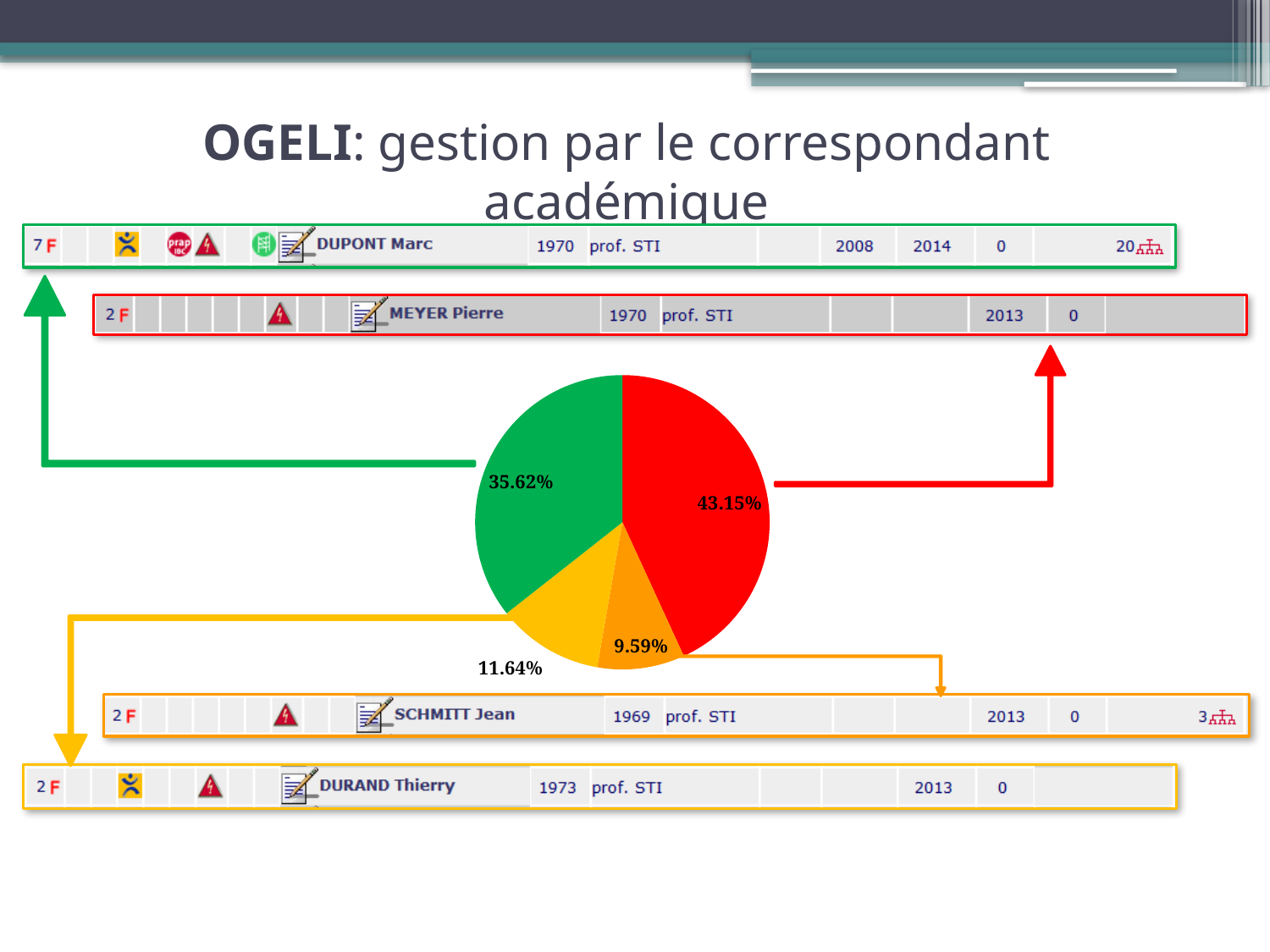
What percentage is shown on the yellow slice of the pie chart? 11.64% Which is larger in the pie chart, the yellow slice or the orange slice? the yellow slice Which person's row does the red arrow from the pie chart point to? MEYER Pierre What percentage is shown on the green slice of the pie chart? 35.62% What percentage is shown on the red slice of the pie chart? 43.15% What is the combined share of the yellow and orange slices of the pie chart? 21.23% What is the difference between the red slice and the green slice of the pie chart? 7.53% What kind of chart is shown on the slide? pie chart Which slice of the pie chart is the smallest? the orange slice (9.59%) What percentage is shown on the orange slice of the pie chart? 9.59% Which slice of the pie chart is the largest? the red slice (43.15%) How many slices does the pie chart have? 4